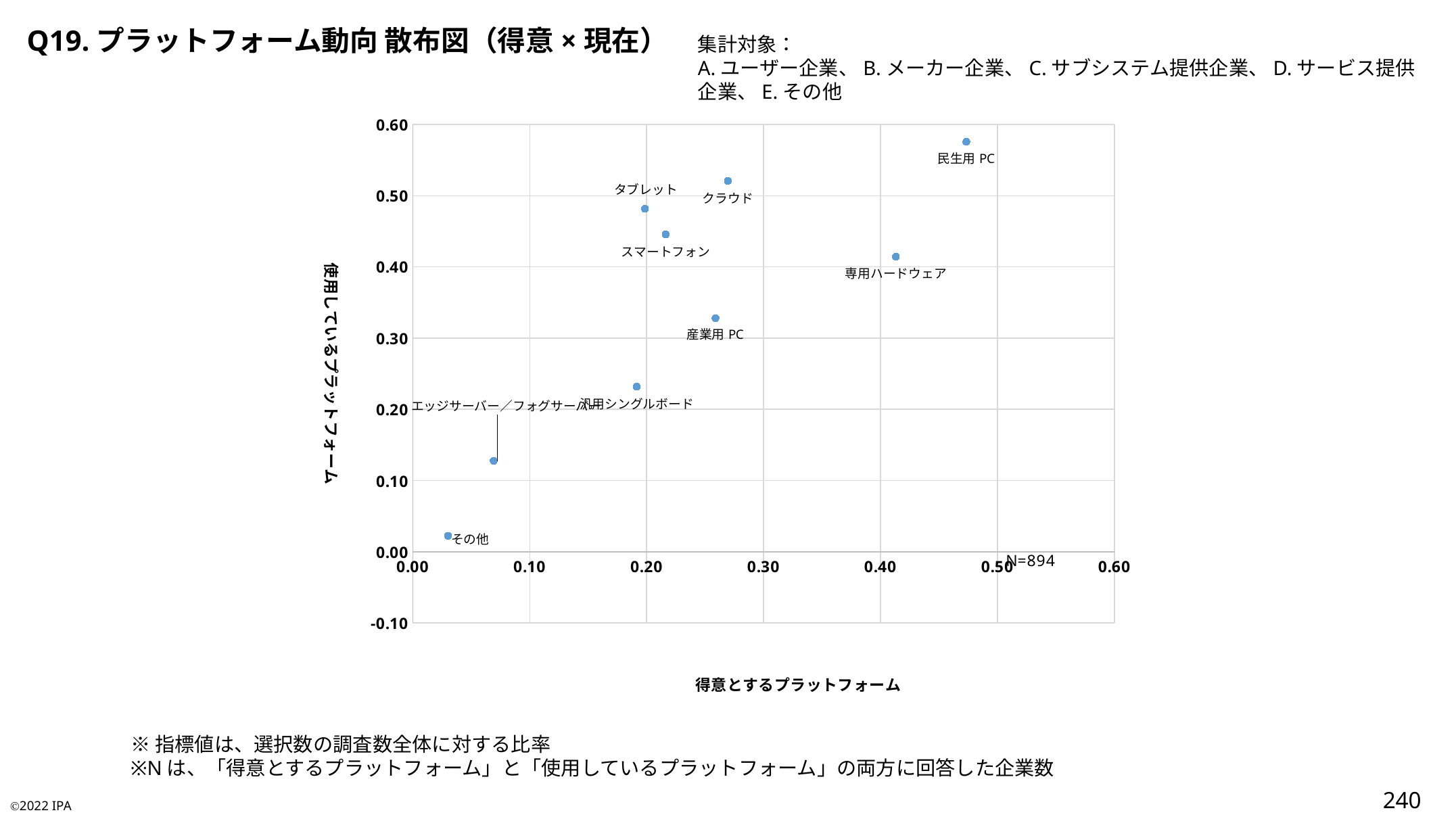
How many data points are plotted in the scatter chart? 9 Is the horizontal-axis value for 専用ハードウェア greater or less than 0.40? greater Which platform has the highest value on the horizontal axis (得意とするプラットフォーム)? 民生用 PC What kind of chart is shown on the slide? scatter chart Which has the higher horizontal-axis value, 専用ハードウェア or スマートフォン? 専用ハードウェア Which platform has the lowest value on the vertical axis (使用しているプラットフォーム)? その他 Which platform has the highest value on the vertical axis (使用しているプラットフォーム)? 民生用 PC Is the vertical-axis value for エッジサーバー／フォグサーバー greater or less than 0.20? less Is the vertical-axis value for 産業用 PC greater or less than 0.40? less What is the N value shown on the chart? N=894 Which has the higher vertical-axis value, タブレット or 産業用 PC? タブレット